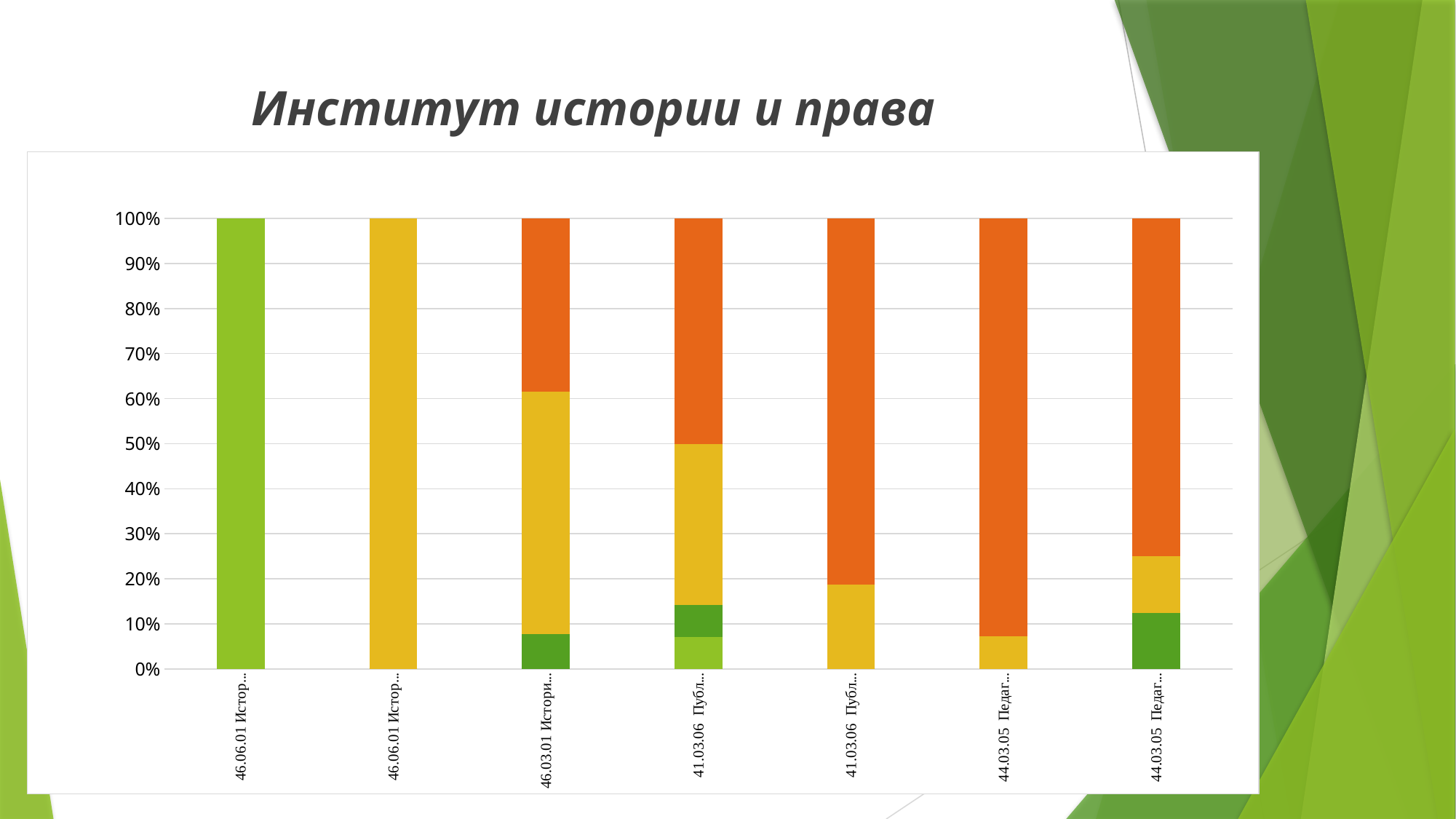
What kind of chart is shown on the slide? stacked bar chart What value does the first bar (46.06.01 Истор...) reach on the vertical axis? 100% In the fourth bar from the left (41.03.06 Публ...), is the top of the dark green segment greater or less than 20%? less In the rightmost bar (44.03.05 Педаг...), is the top of the green segment greater or less than 20%? less What is the title of the slide above the chart? Институт истории и права What colour is the second bar from the left? yellow In the fifth bar from the left (41.03.06 Публ...), is the top of the yellow segment greater or less than 30%? less What is the highest value shown on the vertical axis? 100% How many bars are plotted in the chart? 7